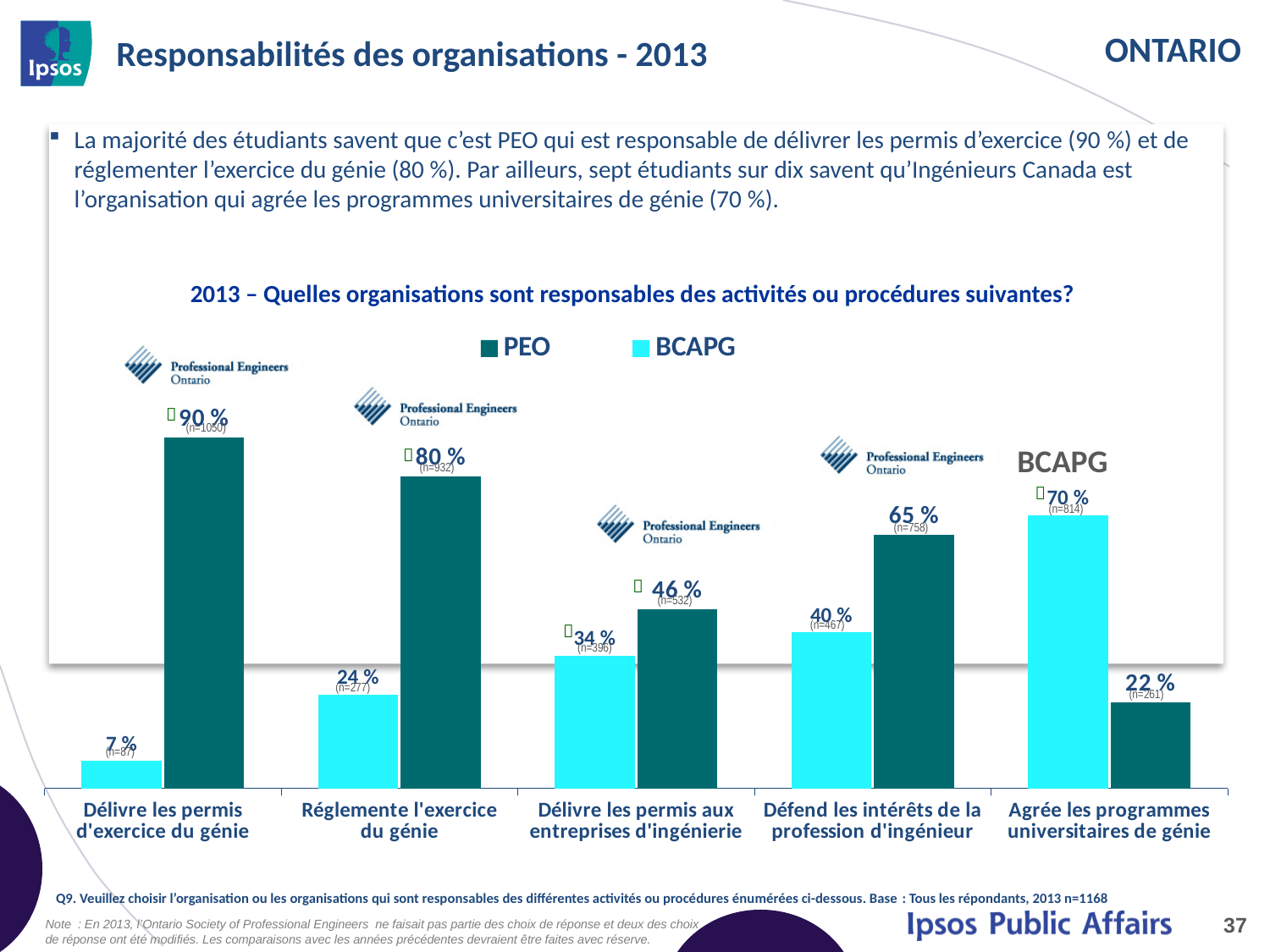
How many series does the legend list? 2 For 'Agrée les programmes universitaires de génie', which series has the larger value, PEO or BCAPG? BCAPG What is the difference between the PEO and BCAPG values for 'Délivre les permis aux entreprises d'ingénierie'? 12 % What is the BCAPG value for 'Réglemente l'exercice du génie'? 24 % Which category has the lowest BCAPG value? Délivre les permis d'exercice du génie What is the BCAPG value for 'Agrée les programmes universitaires de génie'? 70 % Which category has the highest PEO value? Délivre les permis d'exercice du génie How many categories are shown on the x axis? 5 What is the PEO value for 'Délivre les permis d'exercice du génie'? 90 % Which series is shown in dark teal in the legend? PEO What is the PEO value for 'Défend les intérêts de la profession d'ingénieur'? 65 % What kind of chart is shown on the slide? Bar chart